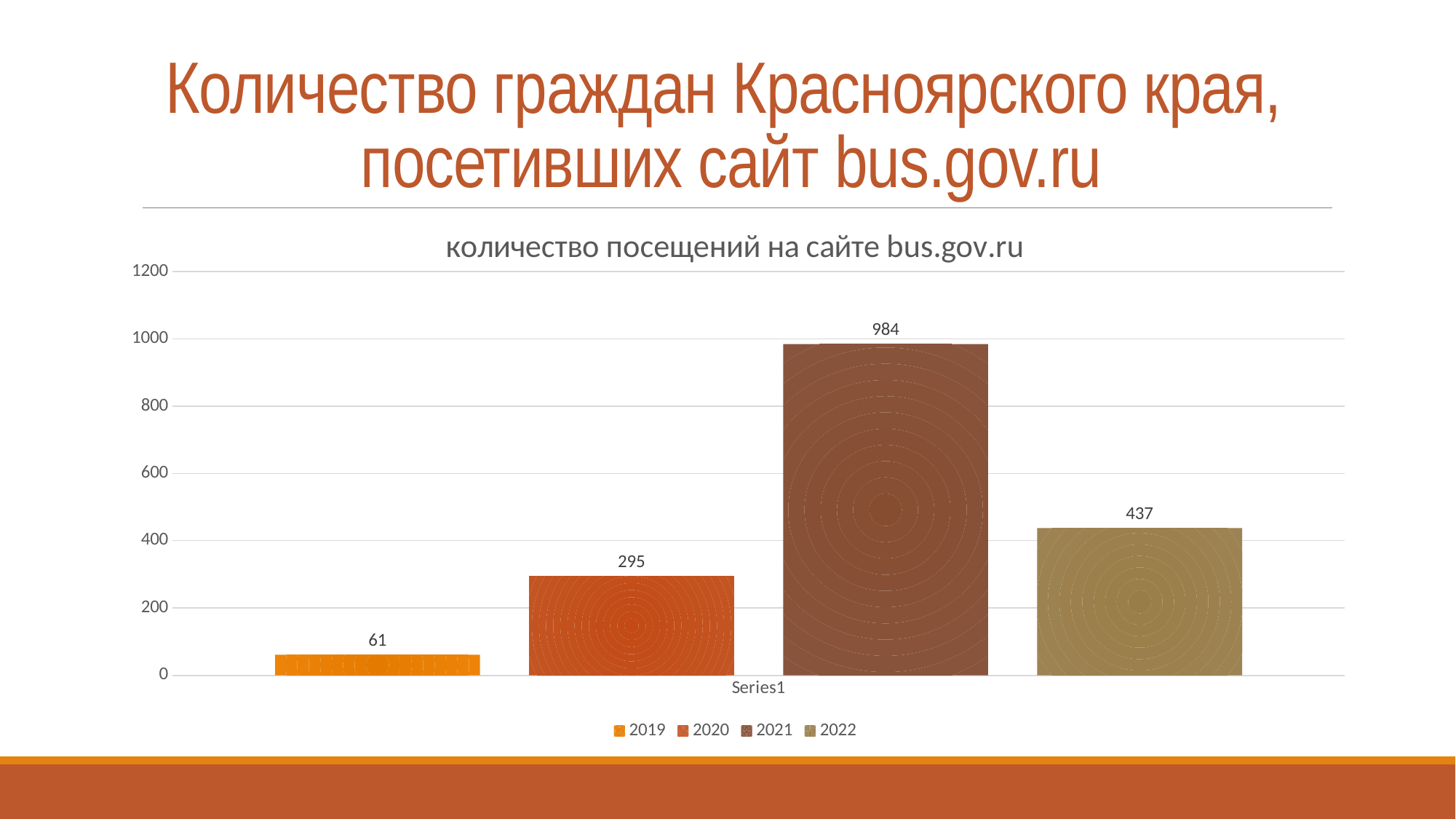
What is the value for 2019? 61 How many series does the legend list? 4 Which year has the lowest value? 2019 What is the value for 2022? 437 What is the difference between the values for 2020 and 2019? 234 Which year has the highest value? 2021 What is the title of the chart? количество посещений на сайте bus.gov.ru Which is larger, the value for 2020 or the value for 2022? 2022 Is the value for 2020 greater or less than 400? less What kind of chart is shown? bar chart What is the difference between the values for 2021 and 2022? 547 What is the value for 2021? 984